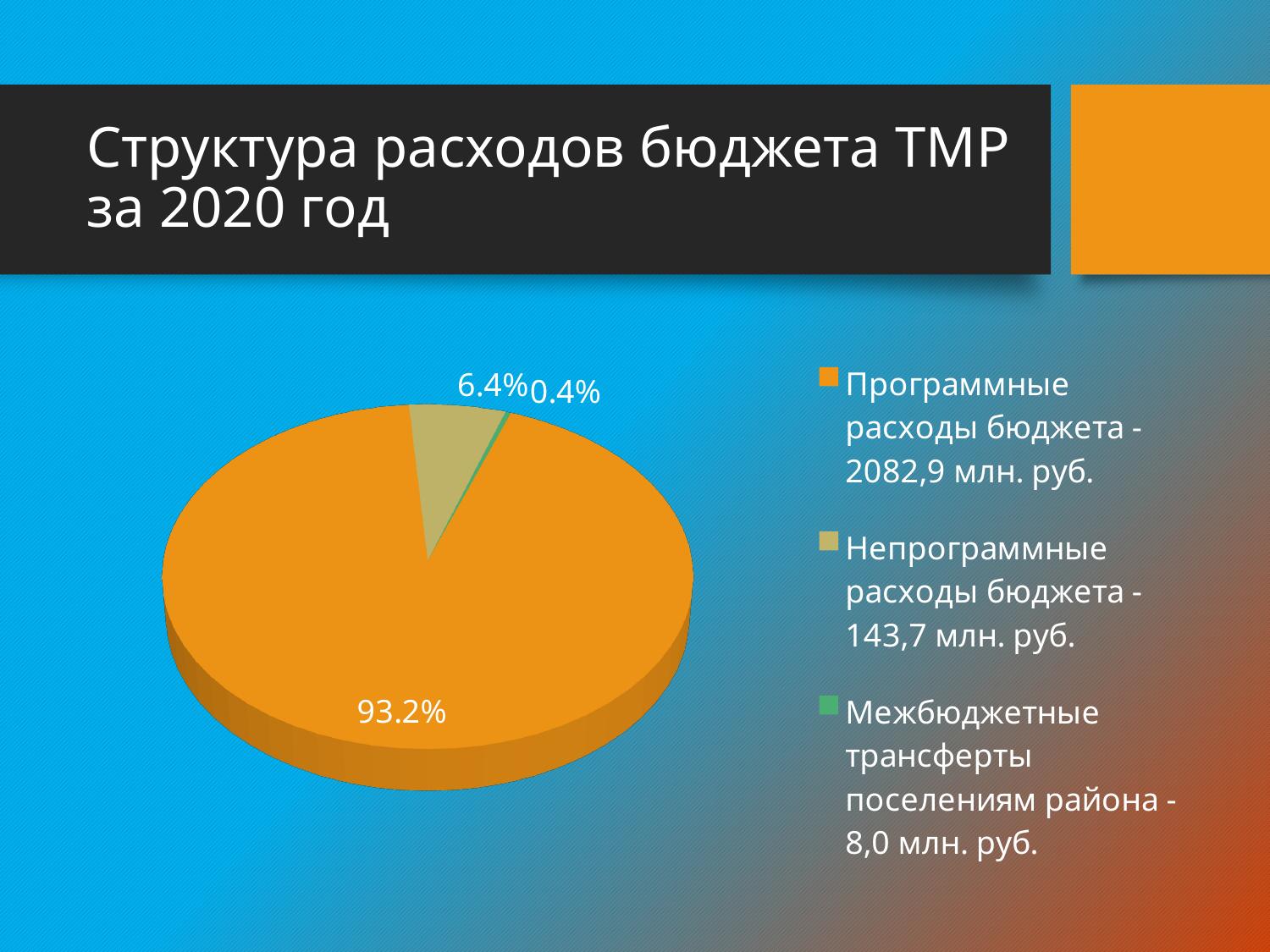
What percentage is shown for Межбюджетные трансферты поселениям района? 0.4% What is the title of the slide containing the chart? Структура расходов бюджета ТМР за 2020 год What colour is the slice for Межбюджетные трансферты поселениям района? Green What percentage is shown for Непрограммные расходы бюджета? 6.4% Which is larger: the share for Непрограммные расходы бюджета or the share for Межбюджетные трансферты поселениям района? Непрограммные расходы бюджета What kind of chart is shown on the slide? Pie chart How many entries does the legend list? 3 Which category has the largest slice of the pie? Программные расходы бюджета How many slices does the pie chart have? 3 What share of the pie does the slice for Программные расходы бюджета represent? 93.2% Which category has the smallest slice of the pie? Межбюджетные трансферты поселениям района What is the difference in percentage points between the Программные расходы бюджета slice and the Непрограммные расходы бюджета slice? 86.8